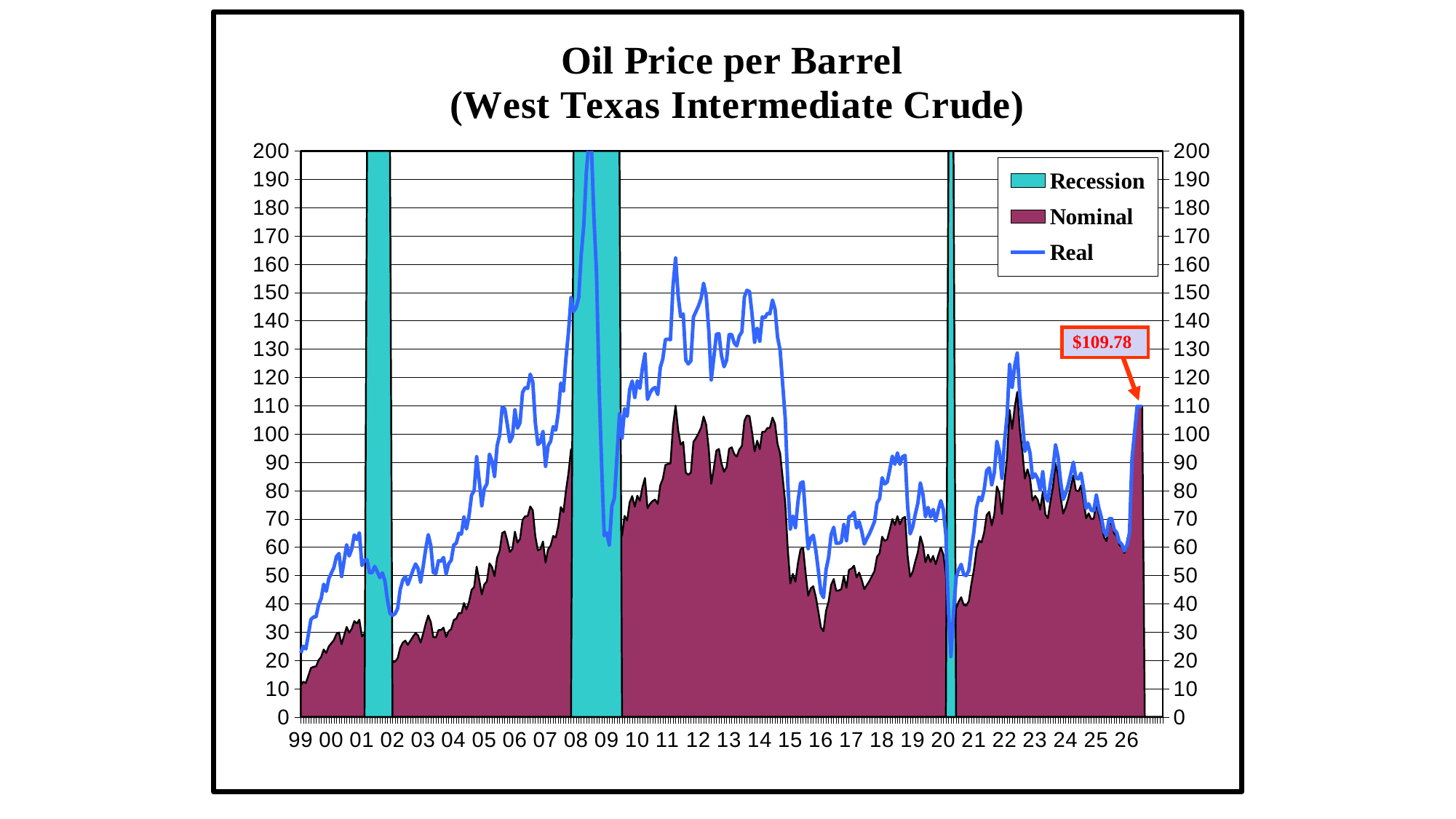
What is the maximum value shown on the vertical axis? 200 In which year does the Real series reach its highest point? 08 What value is printed in the callout label at the right end of the chart? $109.78 Do the oil prices rise or fall between 2014 and 2016? fall Is the peak of the Real series around 2011 greater or less than 150? greater Is the low point of the Nominal series around 2016 greater or less than 40? less Which series is higher in 2011, Real or Nominal? Real Is the Nominal value at the start of the chart in 1999 greater or less than 20? less Which is higher, the Real peak in 2008 or the Real peak in 2022? 2008 How many shaded Recession bands are shown on the chart? 3 What is the title of the chart? Oil Price per Barrel (West Texas Intermediate Crude) How many entries does the chart's legend list? 3